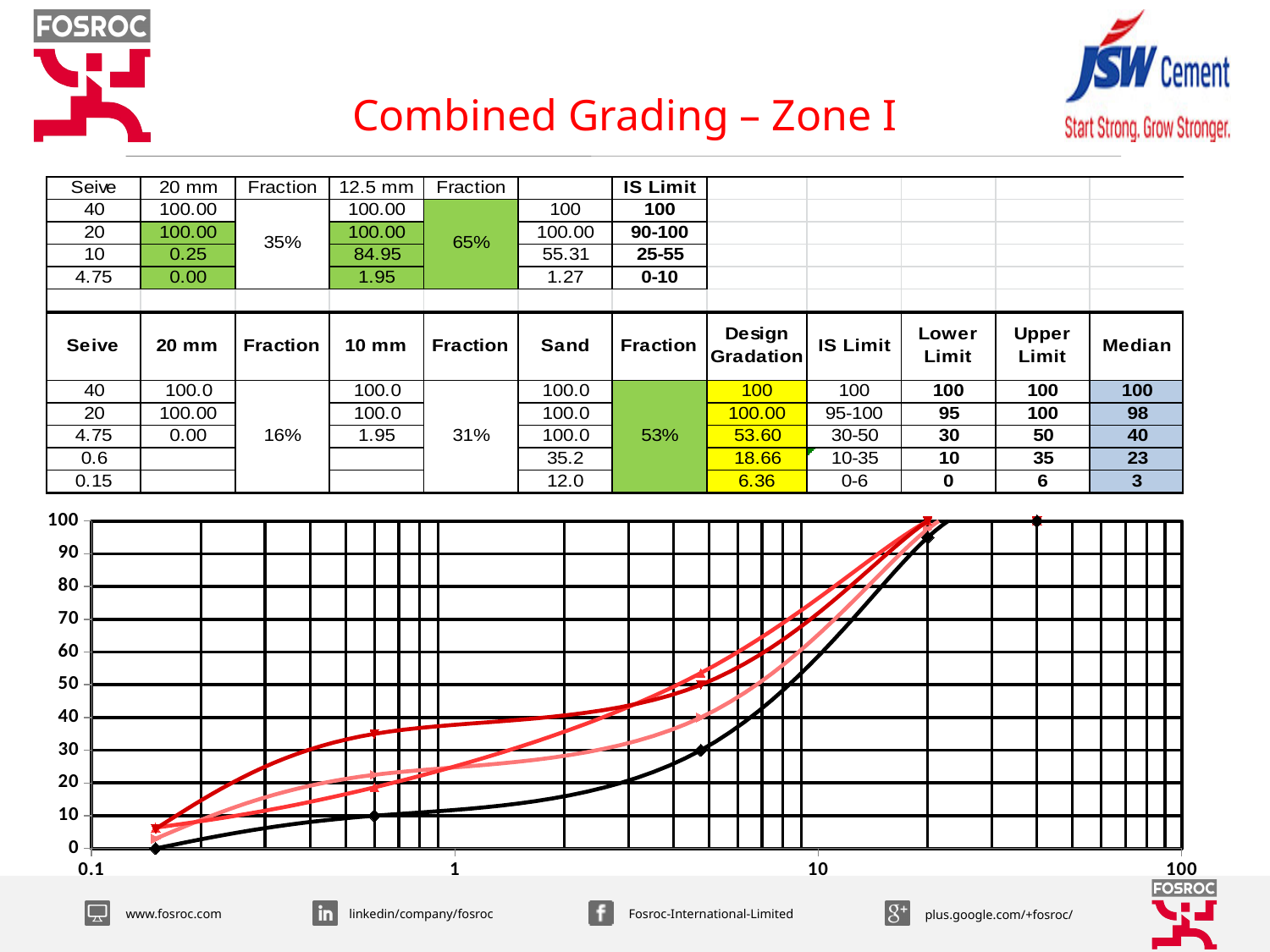
Do the plotted lines rise or fall as the x axis increases from 0.1 to 100? rise At x = 1, is the value of the black line greater or less than 20? less How many lines are plotted on the chart? 4 At x = 1, which line has the higher value, the black line or the dark red line? the dark red line What is the highest value shown on the y axis of the chart? 100 Which line lies lowest on the chart across most of the x axis? the black line What is the smallest tick label shown on the x axis of the chart? 0.1 At x = 1, is the value of the dark red line greater or less than 30? greater At x = 1, which of the four lines has the highest value? the dark red line What kind of chart is shown at the bottom of the slide? line chart At x = 10, is the value of the black line greater or less than 50? greater